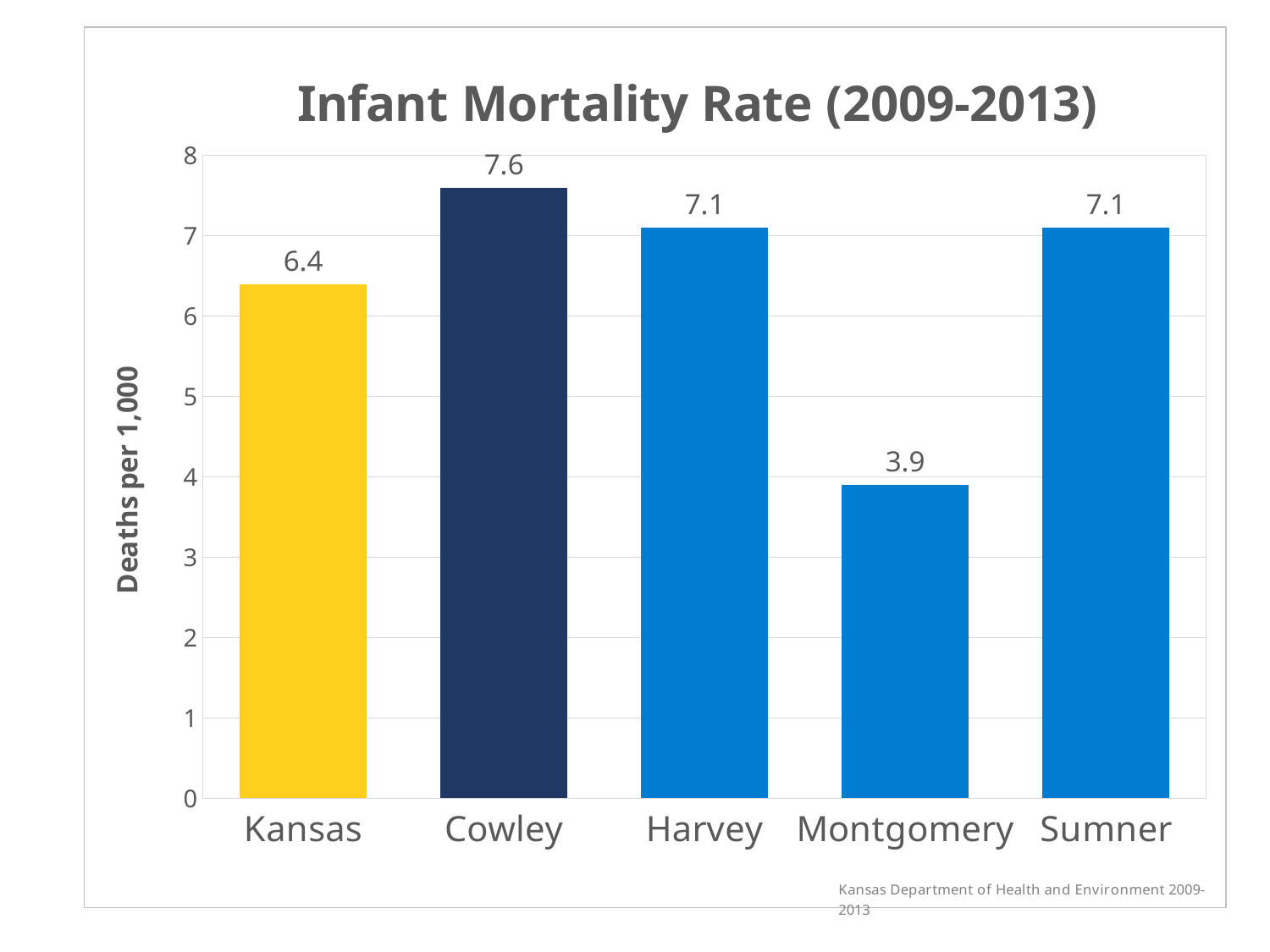
Which category has the lowest infant mortality rate? Montgomery What is the difference between the infant mortality rates of Cowley and Montgomery? 3.7 What is the infant mortality rate for Cowley? 7.6 What is the infant mortality rate for Kansas? 6.4 What is the difference between the infant mortality rates of Harvey and Kansas? 0.7 What kind of chart is shown on the slide? Bar chart What is the infant mortality rate for Montgomery? 3.9 Which has a higher infant mortality rate, Kansas or Cowley? Cowley Which category has the highest infant mortality rate? Cowley What is the title of the chart? Infant Mortality Rate (2009-2013) What is the infant mortality rate for Sumner? 7.1 How many categories are shown on the chart? 5